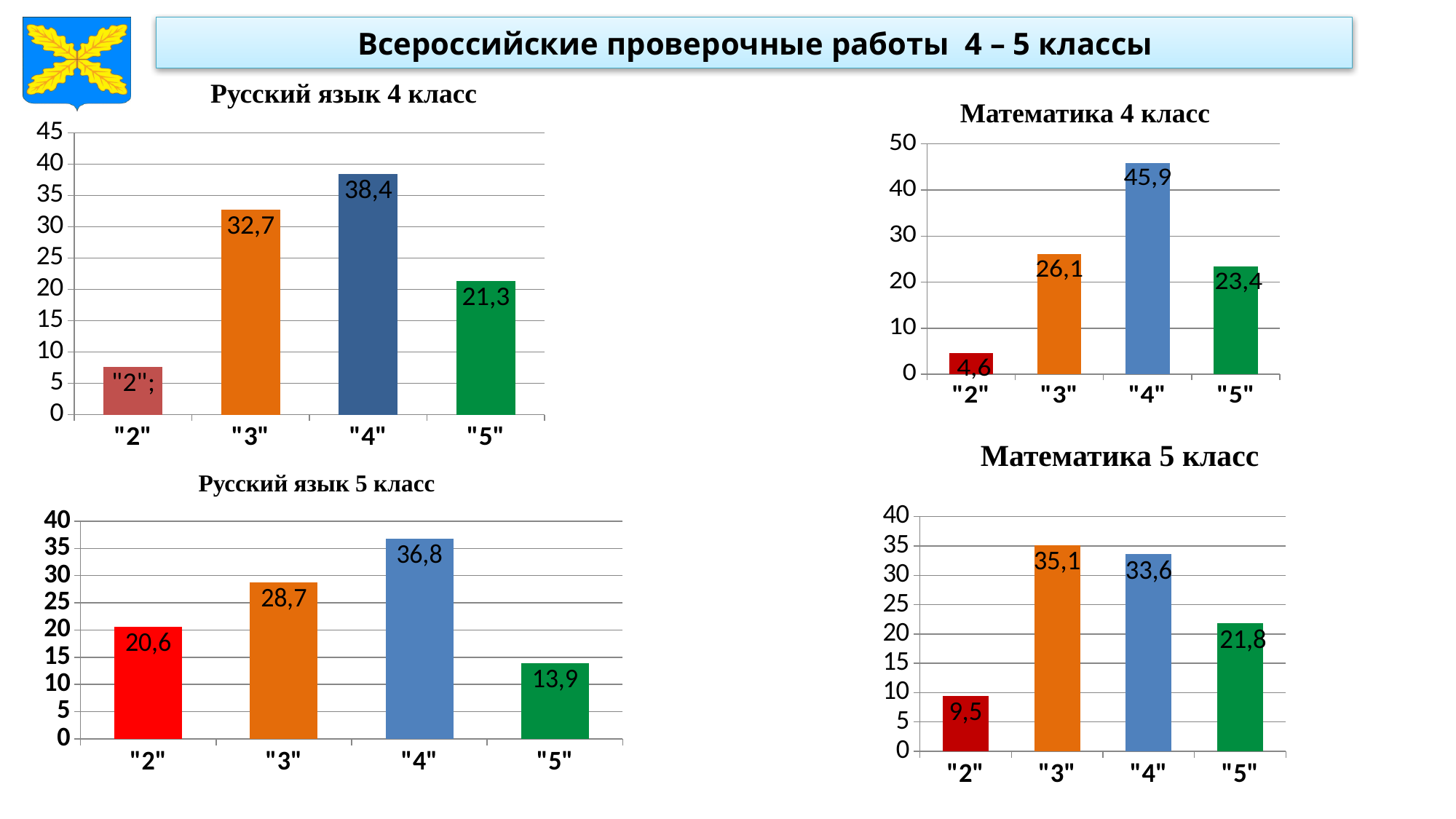
In the "Математика 4 класс" chart, what is the difference between the values for "3" and "5"? 2,7 In the "Математика 5 класс" chart, what is the value for "5"? 21,8 How many categories does the "Математика 5 класс" chart show? 4 In the "Русский язык 5 класс" chart, what is the value for "3"? 28,7 In the "Математика 4 класс" chart, what is the value for "2"? 4,6 In the "Математика 4 класс" chart, which category has the highest value? "4" In the "Русский язык 5 класс" chart, what is the difference between the values for "4" and "2"? 16,2 What kind of chart is "Русский язык 4 класс"? bar chart In the "Математика 5 класс" chart, which is larger, the value for "3" or the value for "4"? "3" In the "Русский язык 5 класс" chart, which category has the lowest value? "5" In the "Русский язык 4 класс" chart, what is the value for "4"? 38,4 In the "Русский язык 4 класс" chart, is the value for "2" greater or less than 10? less